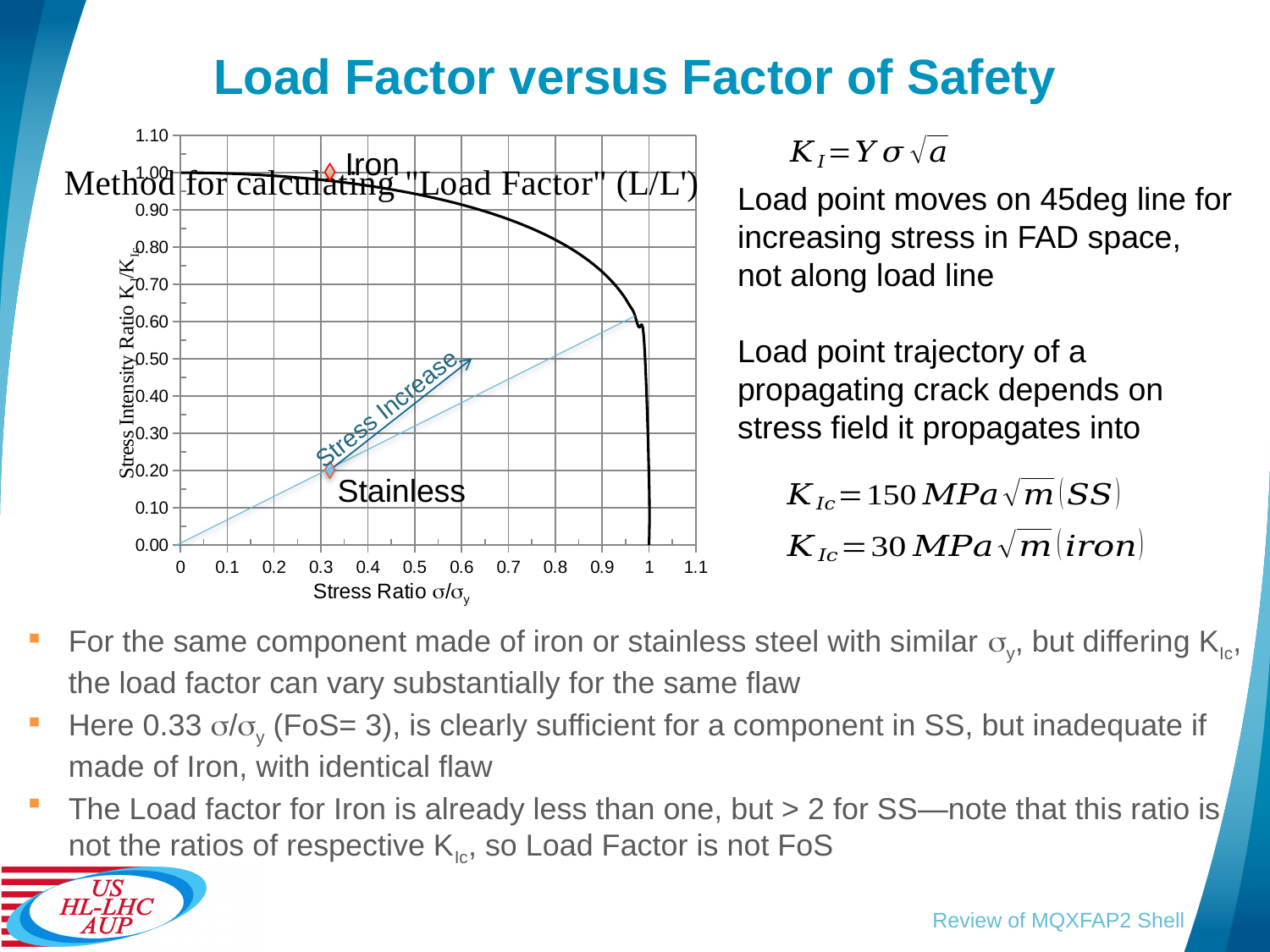
Is the stress ratio of the Iron point greater or less than 0.2? greater Is the stress ratio of the Stainless point greater or less than 0.4? less Is the stress intensity ratio for the Stainless point greater or less than 0.10? greater Does the black failure assessment curve rise or fall as the stress ratio increases along the x axis? fall Which marked point has the higher stress intensity ratio, Iron or Stainless? Iron What is the highest tick value shown on the x axis of the chart? 1.1 What kind of chart is shown on the slide? line chart What is the label of the x axis of the chart? Stress Ratio σ/σy How many labeled material points are marked on the chart? 2 What is the label of the y axis of the chart? Stress Intensity Ratio KI/KIc